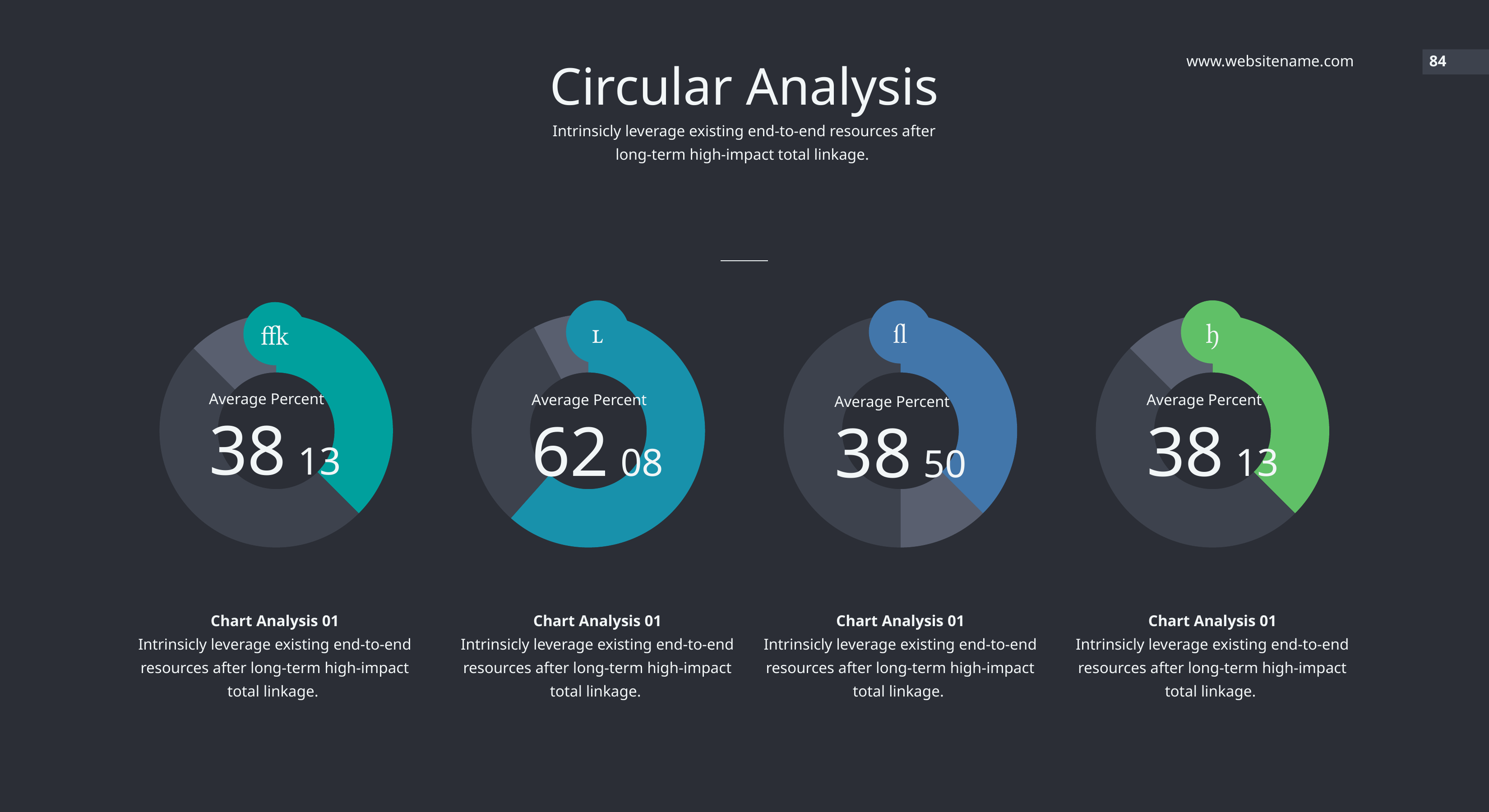
What colour is the highlighted segment of the rightmost donut chart? green In the third donut chart from the left, what is the large number printed in the centre? 38 In the third donut chart from the left, what small number is printed to the right of the large 38? 50 In the rightmost donut chart, what is the large number printed in the centre? 38 In the leftmost donut chart, what is the large number printed in the centre? 38 Which of the four donut charts shows the highest large centre number? the second from the left In the second donut chart from the left, what is the large number printed in the centre? 62 What label is printed above the large number in the centre of each donut chart? Average Percent Is the large centre number of the second donut chart larger or smaller than that of the third donut chart? larger What is the difference between the large centre number of the second donut chart (62) and that of the leftmost donut chart (38)? 24 What kind of chart is used for each of the four charts on the slide? donut chart How many donut charts are shown on the slide? 4